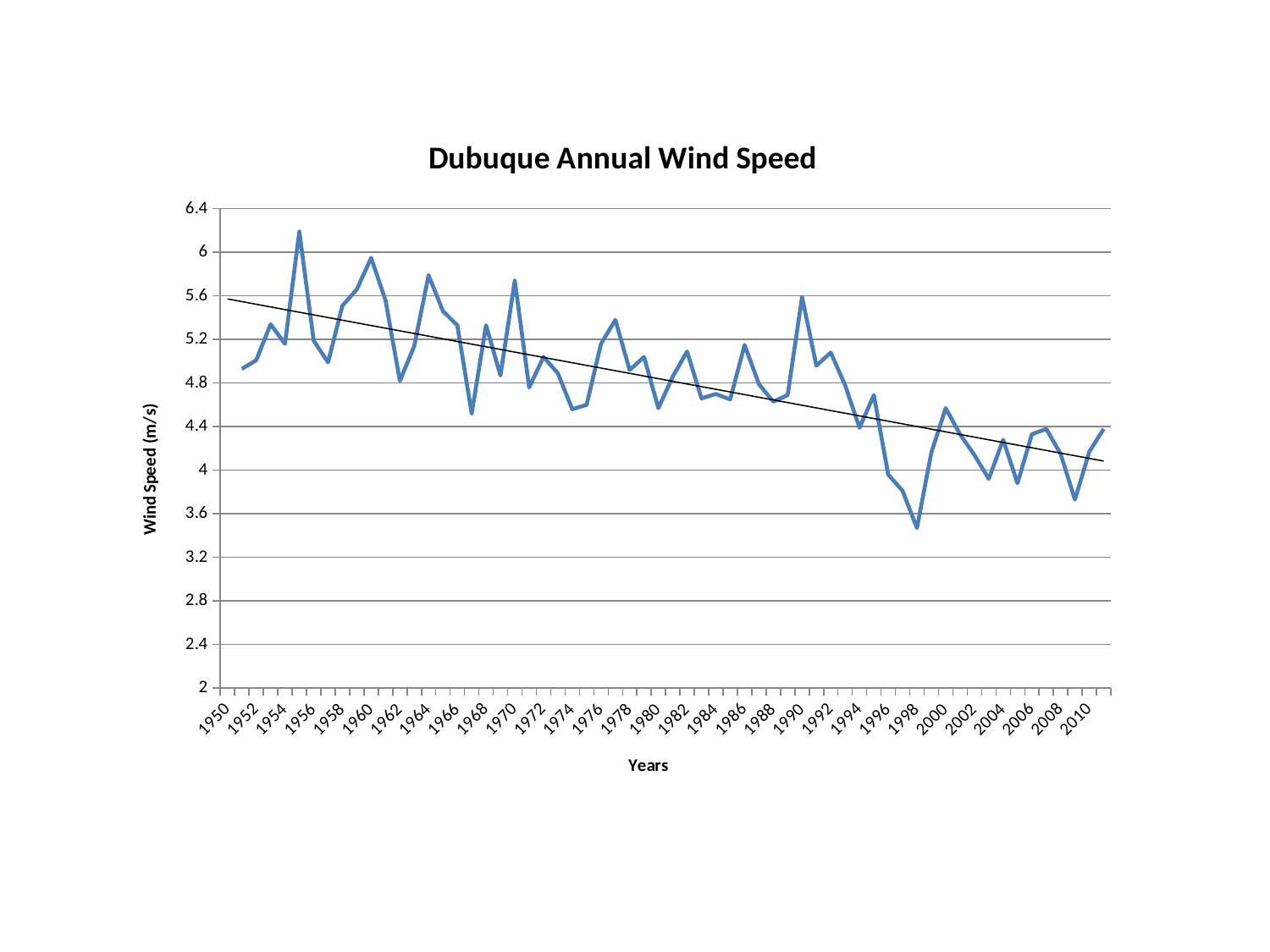
In which year does the wind speed reach its highest value? 1955 What kind of chart is shown on the slide? line chart Overall, does the wind speed rise or fall from 1950 to 2010 according to the trend line? fall What is the label of the vertical axis? Wind Speed (m/s) In which year does the wind speed reach its lowest value? 1998 Is the wind speed for 1955 greater or less than 6? greater Is the wind speed for 1998 greater or less than 3.6? less Is the wind speed for 1960 greater or less than 5.6? greater What is the title of the chart? Dubuque Annual Wind Speed Which year has the higher wind speed, 1960 or 2000? 1960